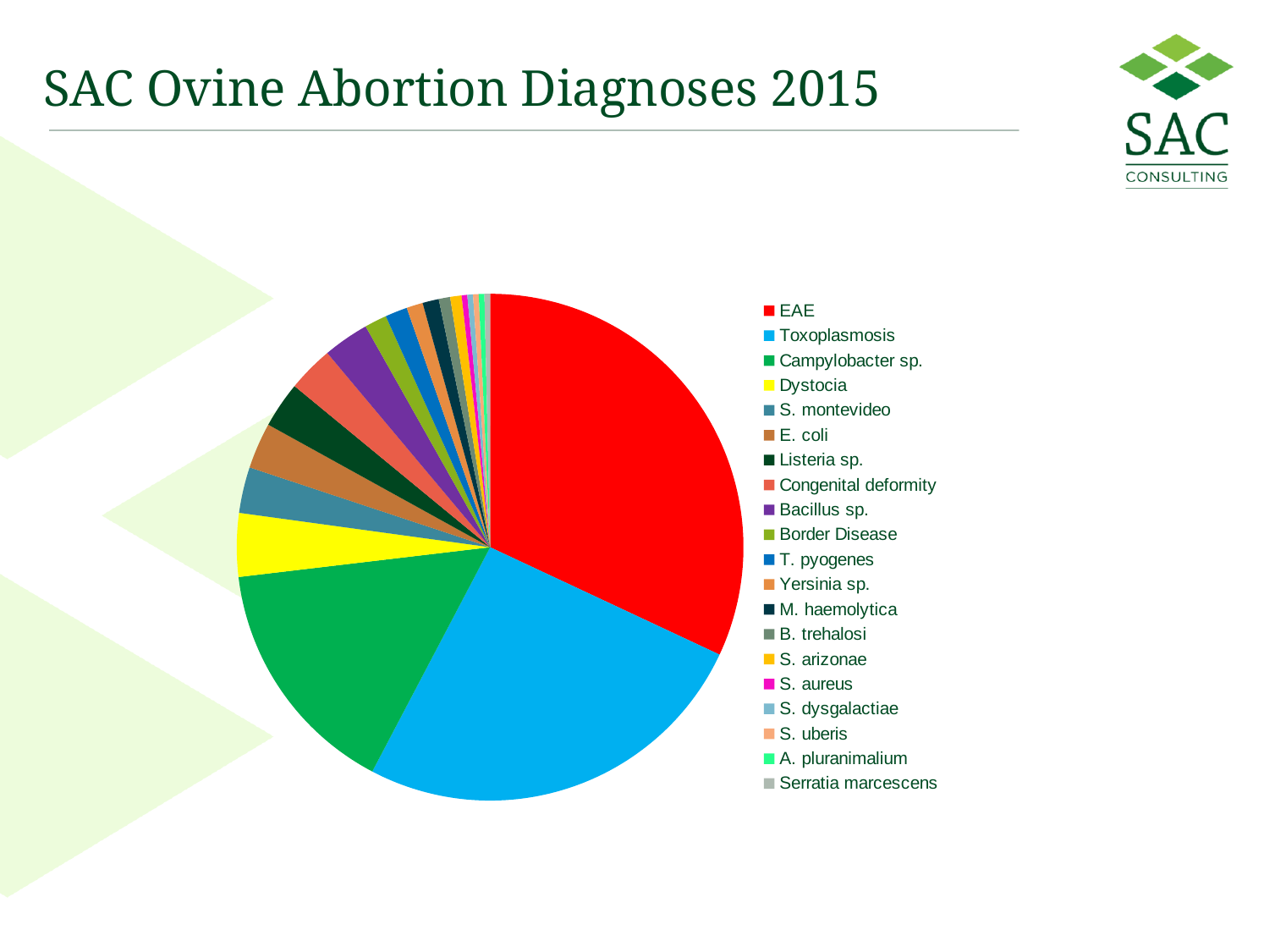
Which slice is larger, Dystocia or S. montevideo? Dystocia Which slice is larger, Toxoplasmosis or Campylobacter sp.? Toxoplasmosis Which slice is larger, Campylobacter sp. or Dystocia? Campylobacter sp. Which category is shown in red in the pie chart? EAE Which category is listed second in the legend of the pie chart? Toxoplasmosis What kind of chart is shown on the slide? pie chart Does the EAE slice account for more or less than half of the pie? less What is the title of the slide containing the pie chart? SAC Ovine Abortion Diagnoses 2015 How many categories does the legend of the pie chart list? 20 Which category has the largest slice of the pie chart? EAE